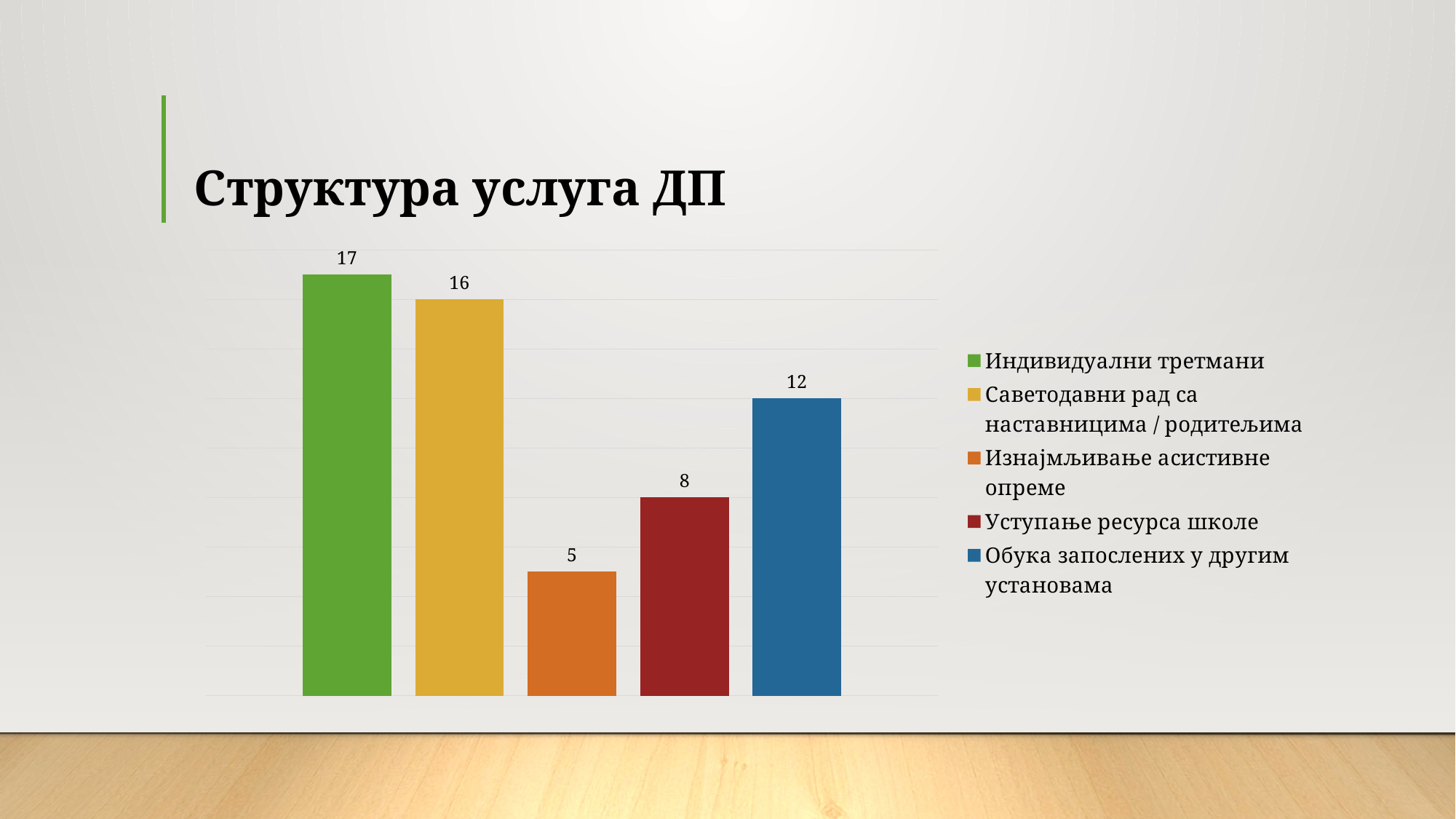
What is the difference between the values for Индивидуални третмани and Обука запослених у другим установама? 5 Which category has the highest value? Индивидуални третмани Which is larger: the value for Уступање ресурса школе or the value for Изнајмљивање асистивне опреме? Уступање ресурса школе Which category has the lowest value? Изнајмљивање асистивне опреме What is the value for Уступање ресурса школе? 8 What is the value for Индивидуални третмани? 17 What is the value for Саветодавни рад са наставницима / родитељима? 16 What is the value for Обука запослених у другим установама? 12 What is the value for Изнајмљивање асистивне опреме? 5 What kind of chart is shown on the slide? Bar chart What is the title of the slide? Структура услуга ДП How many categories are shown in the chart? 5